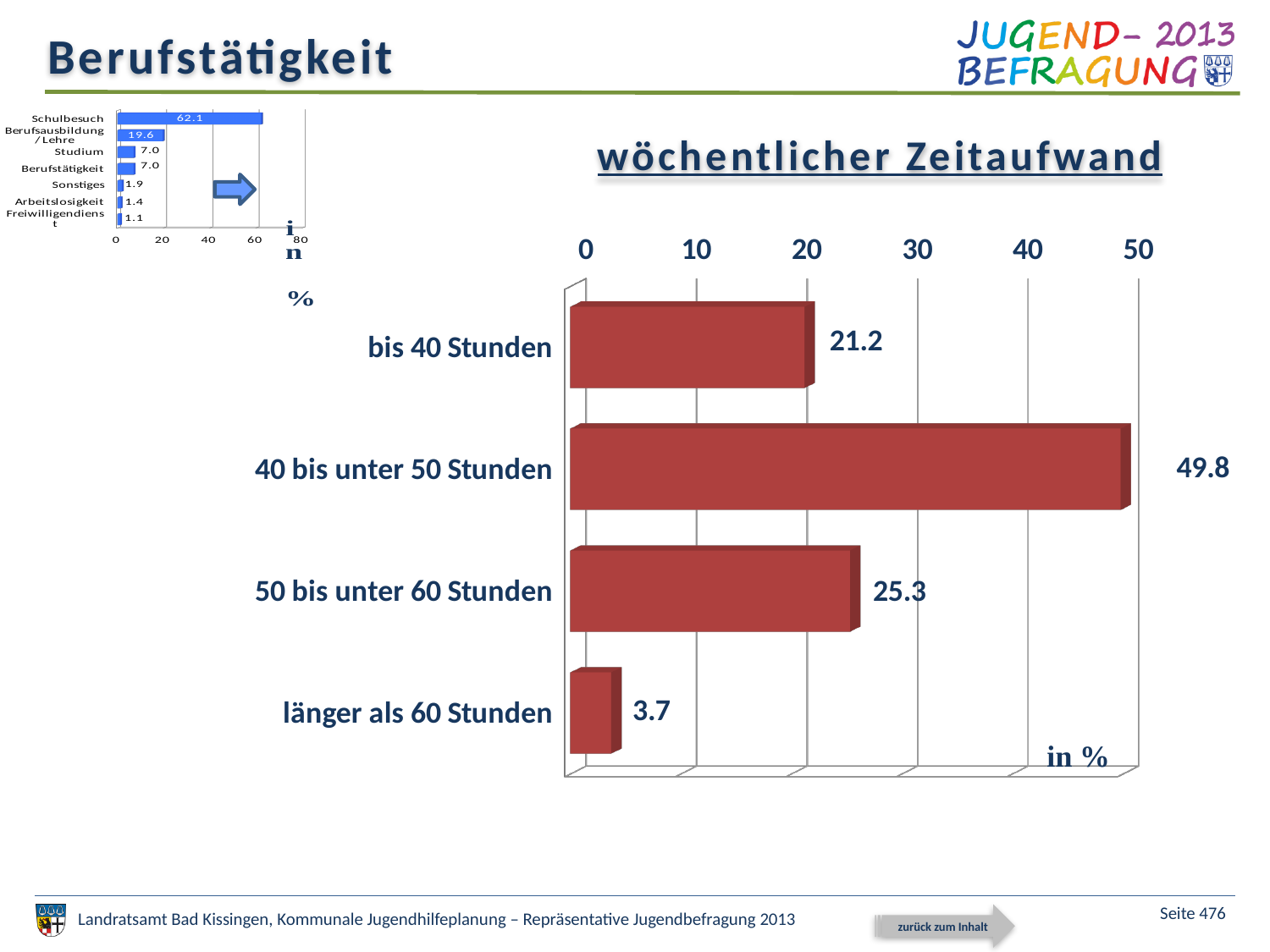
In the 'wöchentlicher Zeitaufwand' chart, which is larger: 'bis 40 Stunden' or '50 bis unter 60 Stunden'? 50 bis unter 60 Stunden How many categories does the 'wöchentlicher Zeitaufwand' chart show? 4 In the 'wöchentlicher Zeitaufwand' chart, which category has the lowest value? länger als 60 Stunden How many categories does the small chart at the top left of the slide show? 7 What kind of chart is the 'wöchentlicher Zeitaufwand' chart? bar chart In the 'wöchentlicher Zeitaufwand' chart, what is the value for 'länger als 60 Stunden'? 3.7 In the small chart at the top left of the slide, what is the value for 'Berufsausbildung / Lehre'? 19.6 In the 'wöchentlicher Zeitaufwand' chart, what is the difference between '50 bis unter 60 Stunden' and 'bis 40 Stunden'? 4.1 In the 'wöchentlicher Zeitaufwand' chart, which category has the highest value? 40 bis unter 50 Stunden In the 'wöchentlicher Zeitaufwand' chart, what is the value for '40 bis unter 50 Stunden'? 49.8 In the small chart at the top left of the slide, which category has the lowest value? Freiwilligendienst In the small chart at the top left of the slide, what is the value for 'Schulbesuch'? 62.1